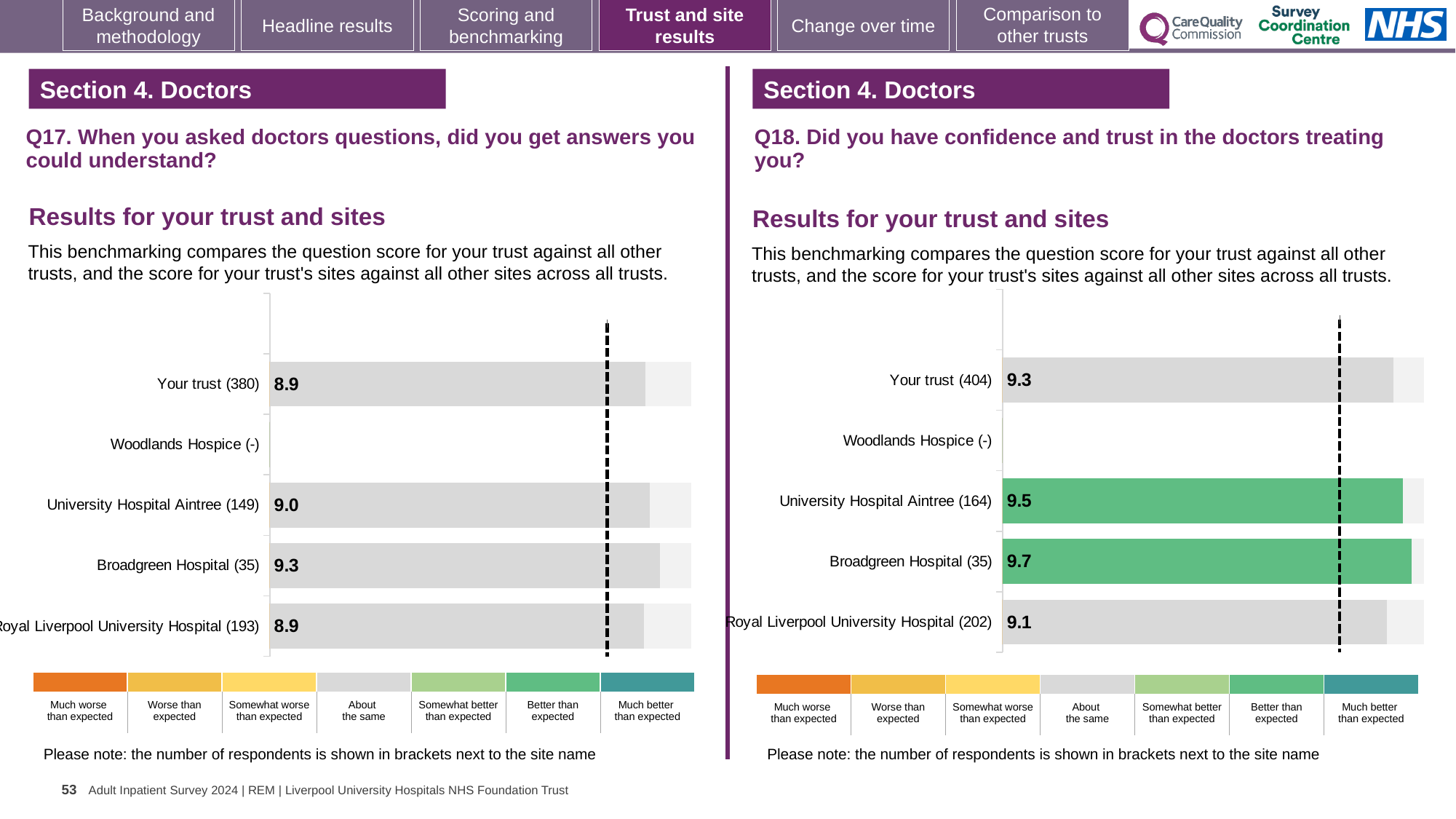
In the Q17 chart on the left, which site has the highest score? Broadgreen Hospital In the Q18 chart on the right, what is the score for Royal Liverpool University Hospital? 9.1 How many site or trust labels are listed on the y axis of the Q17 chart on the left? 5 In the Q18 chart on the right, what is the difference between the scores for Broadgreen Hospital and Your trust? 0.4 In the Q17 chart on the left, what is the difference between the scores for Broadgreen Hospital and University Hospital Aintree? 0.3 In the Q17 chart on the left, what is the score for Your trust? 8.9 In the Q18 chart on the right, which site with a score has the lowest score? Royal Liverpool University Hospital What kind of chart is the Q18 chart on the right? Bar chart In the Q17 chart on the left, what is the score for Broadgreen Hospital? 9.3 In the Q18 chart on the right, which is larger: the score for Your trust or the score for Broadgreen Hospital? Broadgreen Hospital In the Q18 chart on the right, which site has the highest score? Broadgreen Hospital In the Q18 chart on the right, what is the score for University Hospital Aintree? 9.5